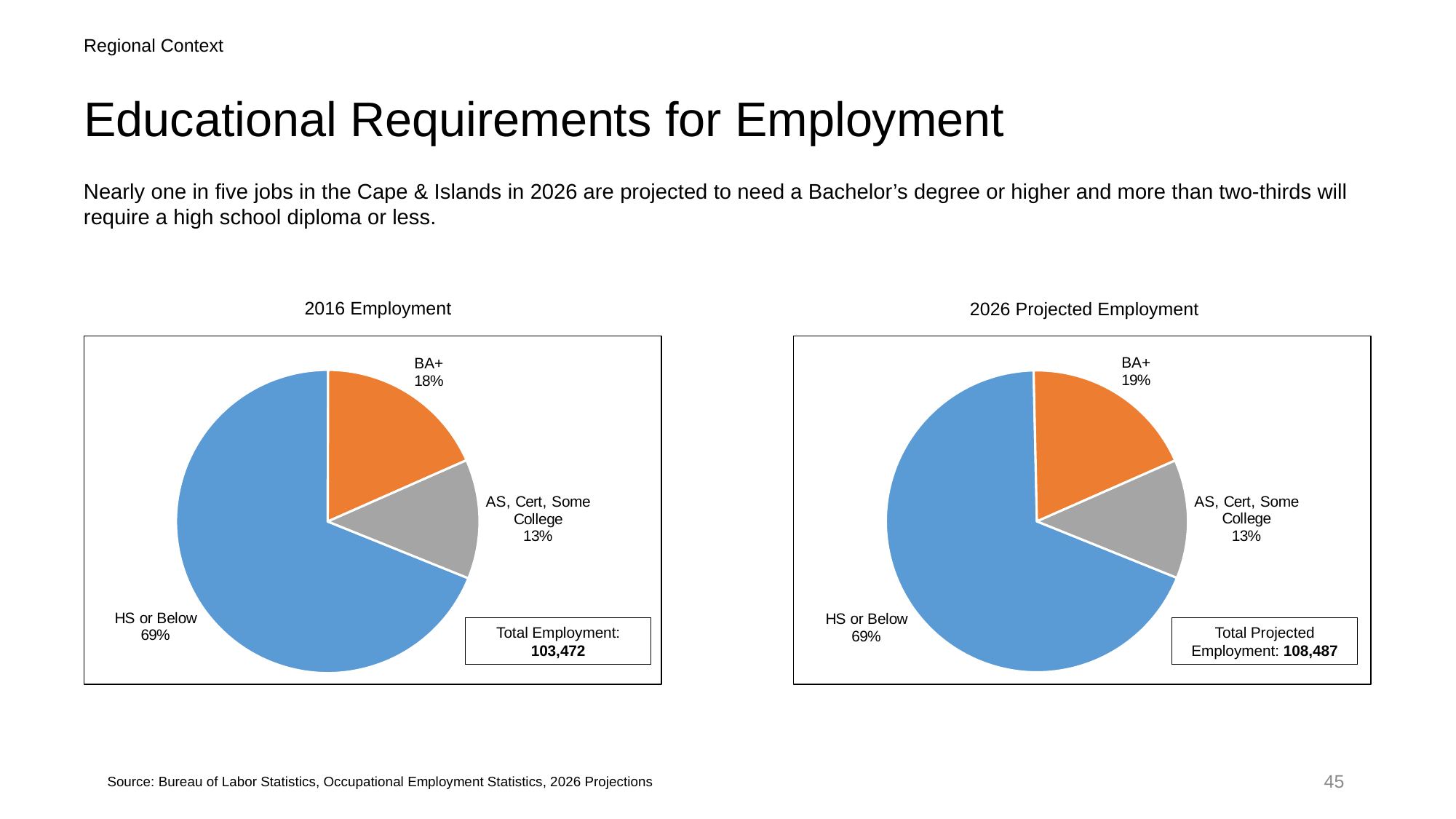
In the 2026 Projected Employment chart, which category has the smallest slice? AS, Cert, Some College How many categories does the 2016 Employment pie chart show? 3 What kind of chart is the 2026 Projected Employment chart? Pie chart In the 2016 Employment chart, what share of jobs is labelled HS or Below? 69% In the 2016 Employment chart, what share of jobs is labelled BA+? 18% In the 2026 Projected Employment chart, what share of jobs is labelled BA+? 19% In the 2016 Employment chart, which category has the largest slice? HS or Below What total projected employment figure is shown in the box on the 2026 Projected Employment chart? 108,487 What total employment figure is shown in the box on the 2016 Employment chart? 103,472 In the 2016 Employment chart, what is the difference in percentage points between the BA+ slice and the AS, Cert, Some College slice? 5 percentage points In the 2026 Projected Employment chart, which is larger, the BA+ slice or the AS, Cert, Some College slice? BA+